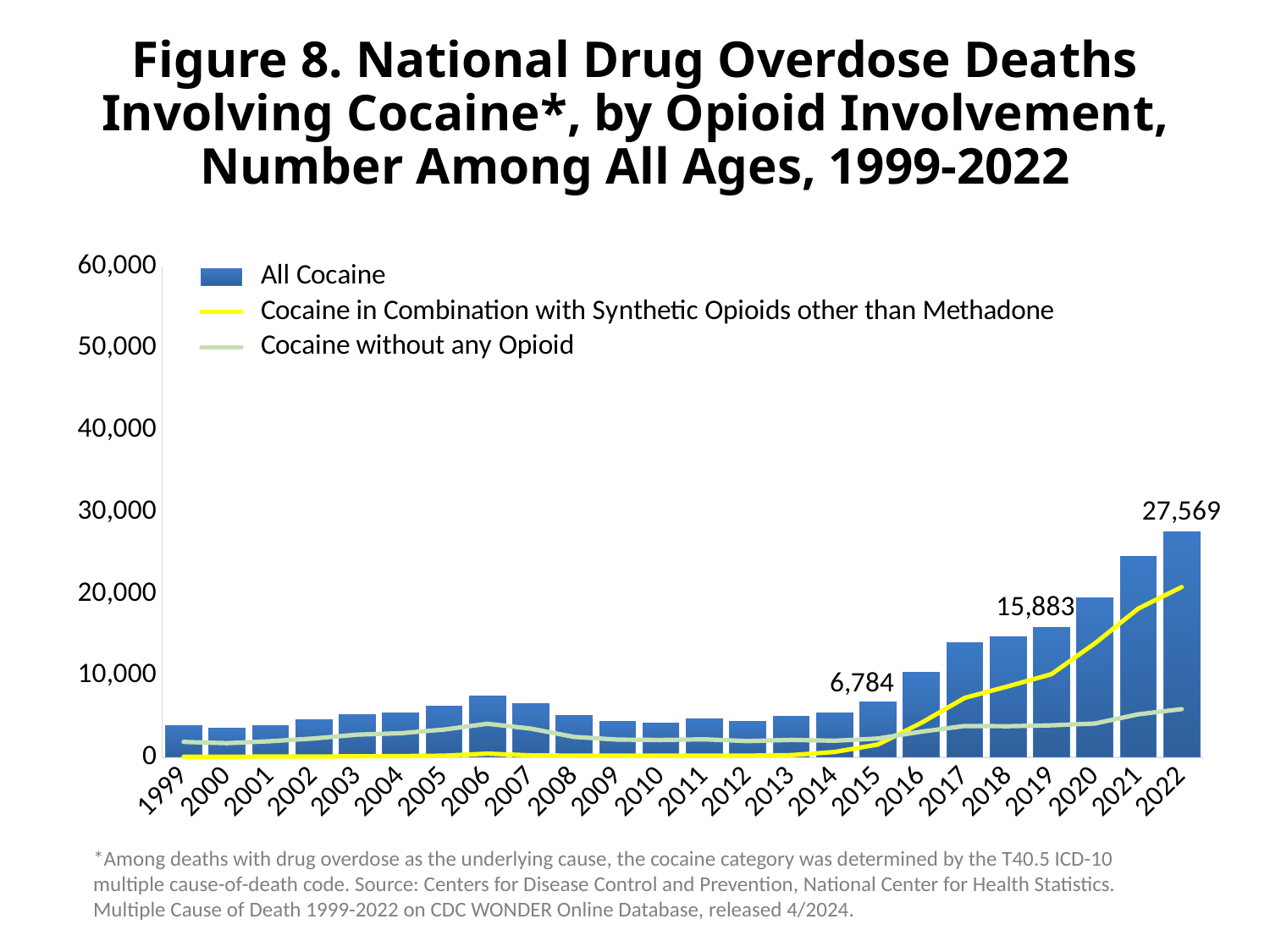
Is the value for Cocaine without any Opioid in 2022 greater or less than 10,000? less Which year has the highest number of All Cocaine deaths? 2022 How many years are shown on the x axis? 24 Is the value for All Cocaine deaths in 2021 greater or less than 20,000? greater How many series does the legend list? 3 Which series is shown as a yellow line? Cocaine in Combination with Synthetic Opioids other than Methadone What is the value of All Cocaine deaths in 2022? 27,569 Which year has more All Cocaine deaths, 2006 or 2010? 2006 What is the value of All Cocaine deaths in 2015? 6,784